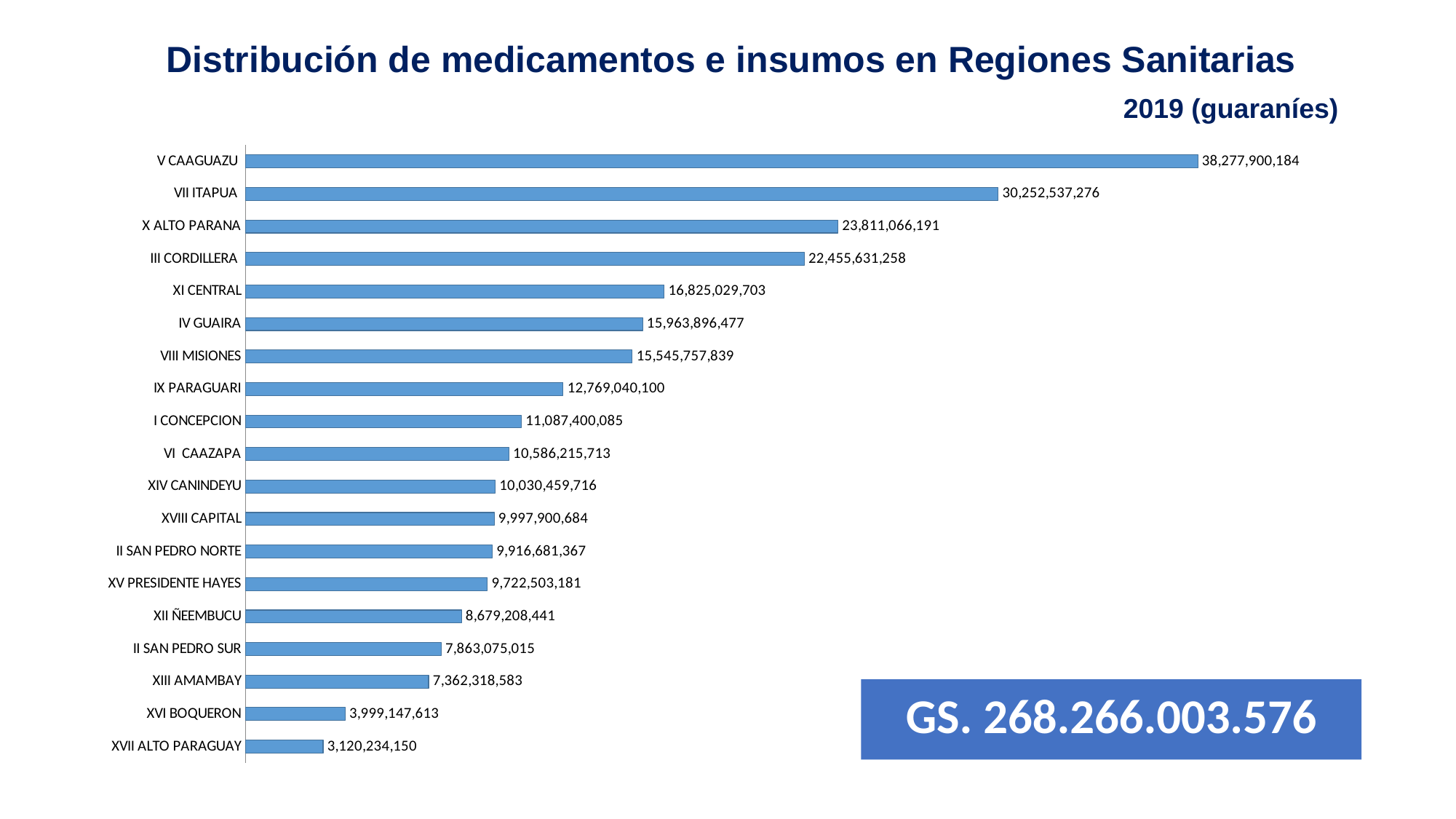
Which region has the lowest value? XVII ALTO PARAGUAY What is the value for XVII ALTO PARAGUAY? 3,120,234,150 What is the difference between the values for V CAAGUAZU and VII ITAPUA? 8,025,362,908 What is the title of the chart? Distribución de medicamentos e insumos en Regiones Sanitarias Which is larger, the value for X ALTO PARANA or the value for III CORDILLERA? X ALTO PARANA What kind of chart is shown on the slide? Bar chart What is the value for V CAAGUAZU? 38,277,900,184 What is the difference between the values for XVI BOQUERON and XVII ALTO PARAGUAY? 878,913,463 Which region has the highest value? V CAAGUAZU What is the value for XI CENTRAL? 16,825,029,703 How many regions are shown in the chart? 19 What is the value for XII ÑEEMBUCU? 8,679,208,441